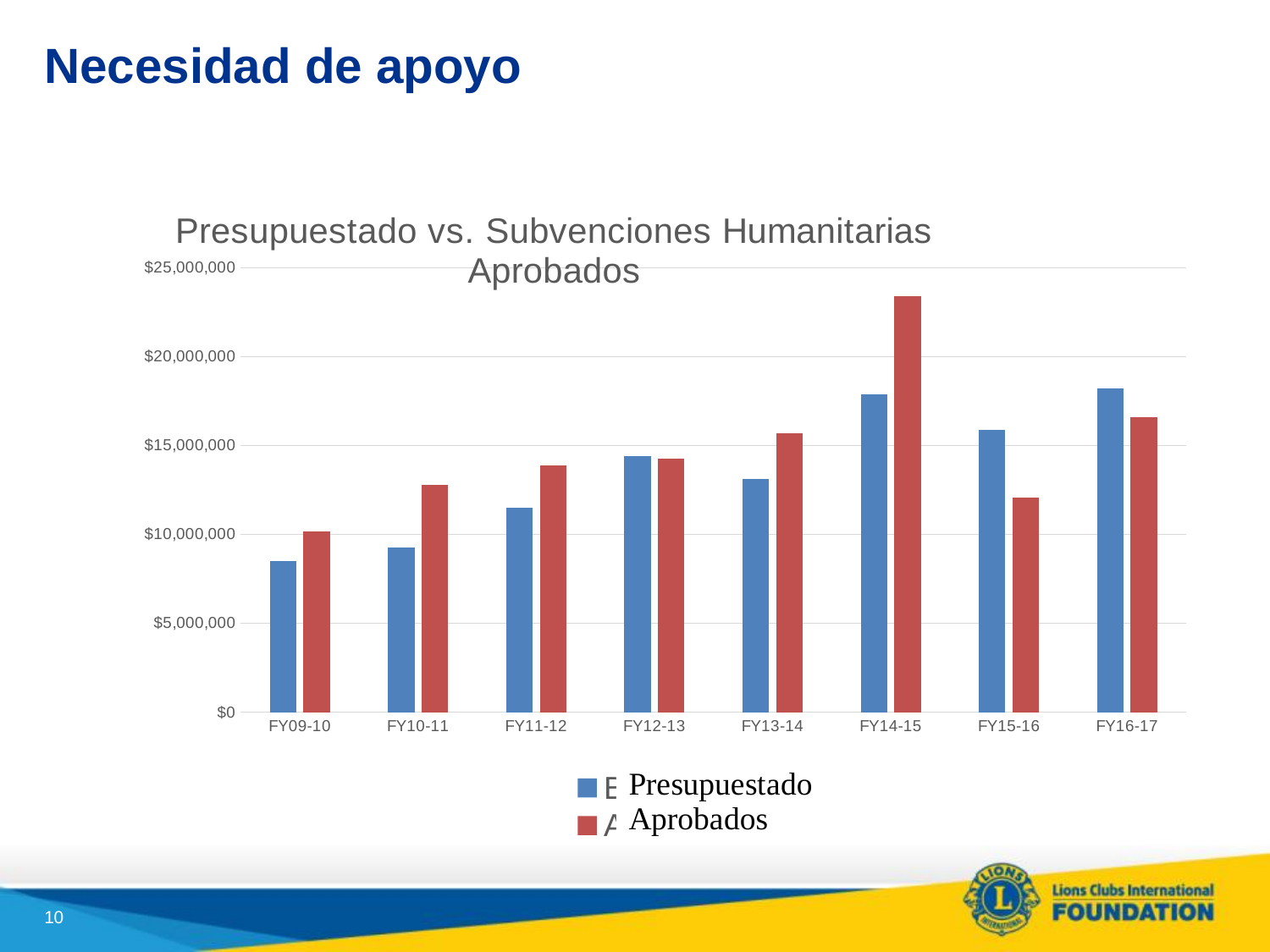
What is the title of the chart? Presupuestado vs. Subvenciones Humanitarias Aprobados How many fiscal years are shown on the x axis of the chart? 8 In FY15-16, which is larger, Presupuestado or Aprobados? Presupuestado Which fiscal year has the lowest Presupuestado value? FY09-10 In FY13-14, which is larger, Presupuestado or Aprobados? Aprobados Which fiscal year has the highest Aprobados value? FY14-15 Is the Presupuestado value for FY16-17 greater or less than $15,000,000? greater How many series does the chart legend list? 2 What kind of chart is shown on the slide? bar chart Which fiscal year has the lowest Aprobados value? FY09-10 Is the Presupuestado value for FY09-10 greater or less than $10,000,000? less Is the Aprobados value for FY14-15 greater or less than $20,000,000? greater